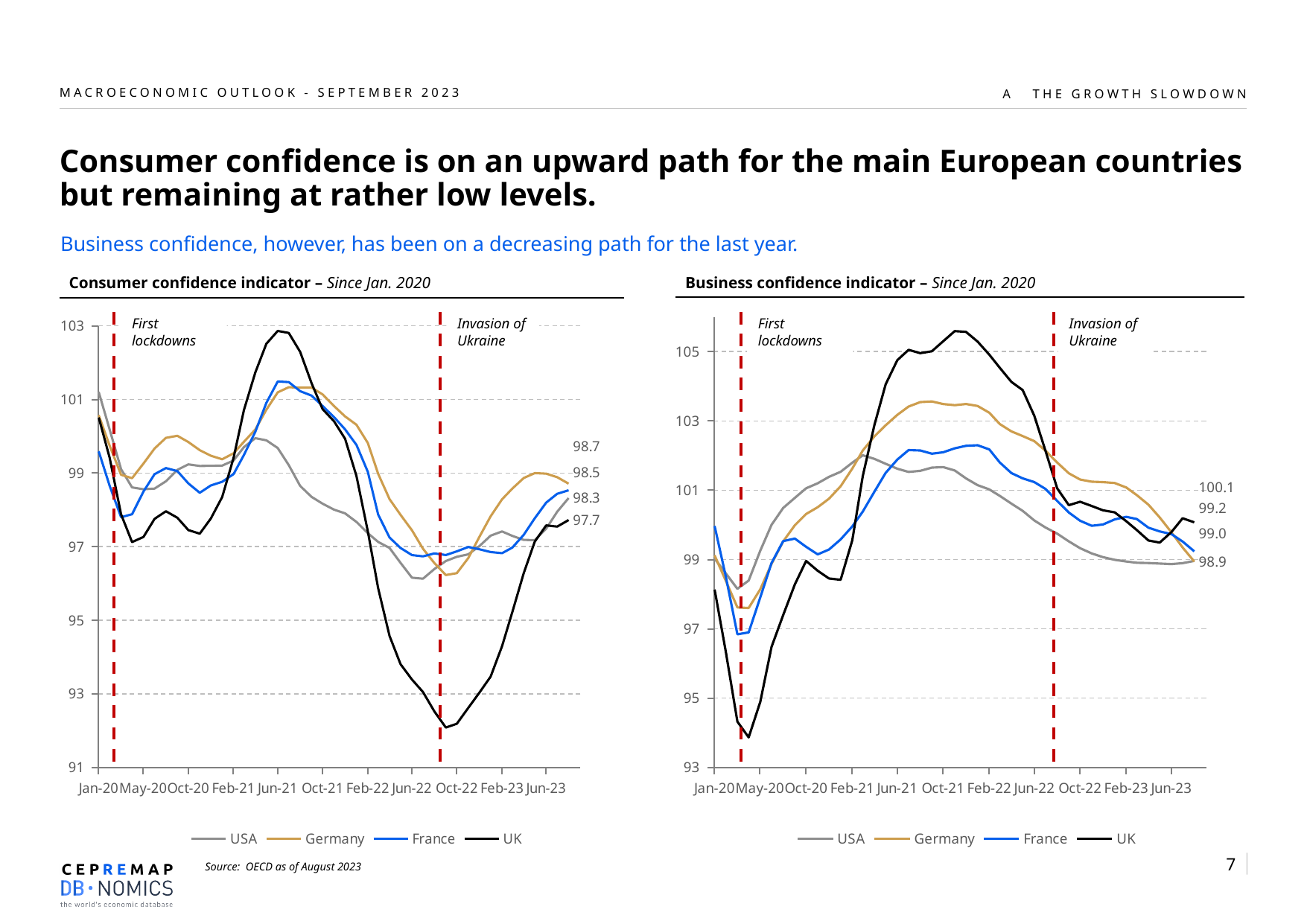
In the Business confidence indicator chart, which country has the highest value at the end of the series? UK In the Business confidence indicator chart, what is the latest value shown for the UK? 100.1 How many series does the legend of the Business confidence indicator chart list? 4 Which countries are listed in the legend of the Consumer confidence indicator chart? USA, Germany, France, UK What two events are marked by the red dashed vertical lines on the charts? First lockdowns and Invasion of Ukraine In the Business confidence indicator chart, is the peak of the UK line (around Oct-21) greater or less than 105? greater In the Consumer confidence indicator chart, what is the difference between the latest values for Germany (98.7) and the UK (97.7)? 1.0 What kind of chart is the Consumer confidence indicator chart? line chart In the Consumer confidence indicator chart, what is the latest value shown for the UK? 97.7 In the Consumer confidence indicator chart, does the UK line rise or fall between Jun-21 and Oct-22? fall In the Consumer confidence indicator chart, is the lowest point of the UK line (around Oct-22) greater or less than 93? less In the Consumer confidence indicator chart, which country has the lowest value at the end of the series? UK